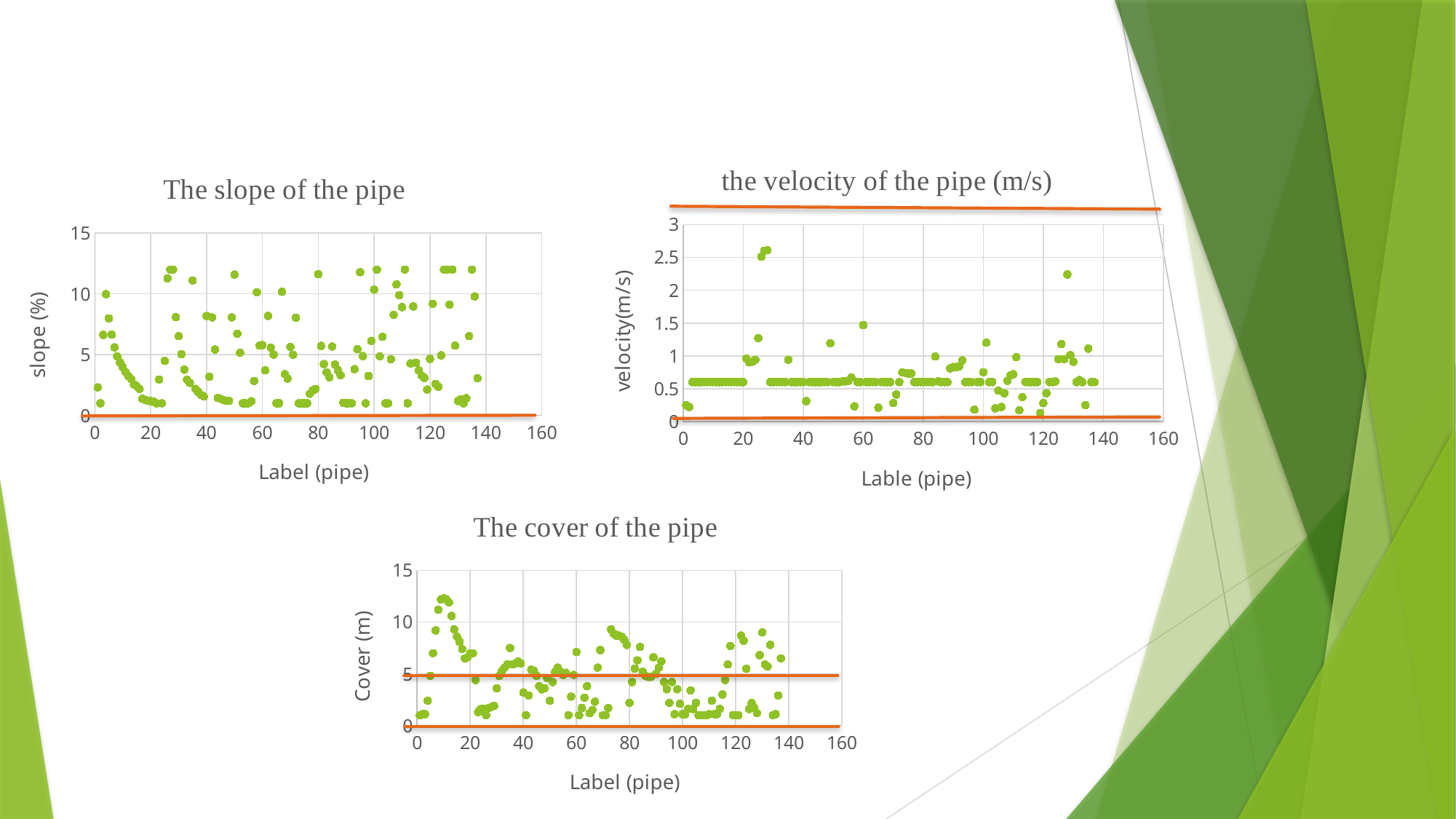
What is the maximum value shown on the horizontal axis of "The slope of the pipe" chart? 160 What is the title of the chart in the top right of the slide? the velocity of the pipe (m/s) In "The cover of the pipe" chart, is the highest plotted cover value greater or less than 10? greater What kind of chart is "The cover of the pipe"? scatter chart In "The cover of the pipe" chart, what is the label of the vertical axis? Cover (m) In "the velocity of the pipe (m/s)" chart, are most of the plotted points greater or less than 1? less In "the velocity of the pipe (m/s)" chart, is the highest plotted velocity value greater or less than 2? greater What kind of chart is "The slope of the pipe"? scatter chart How many charts are shown on the slide? 3